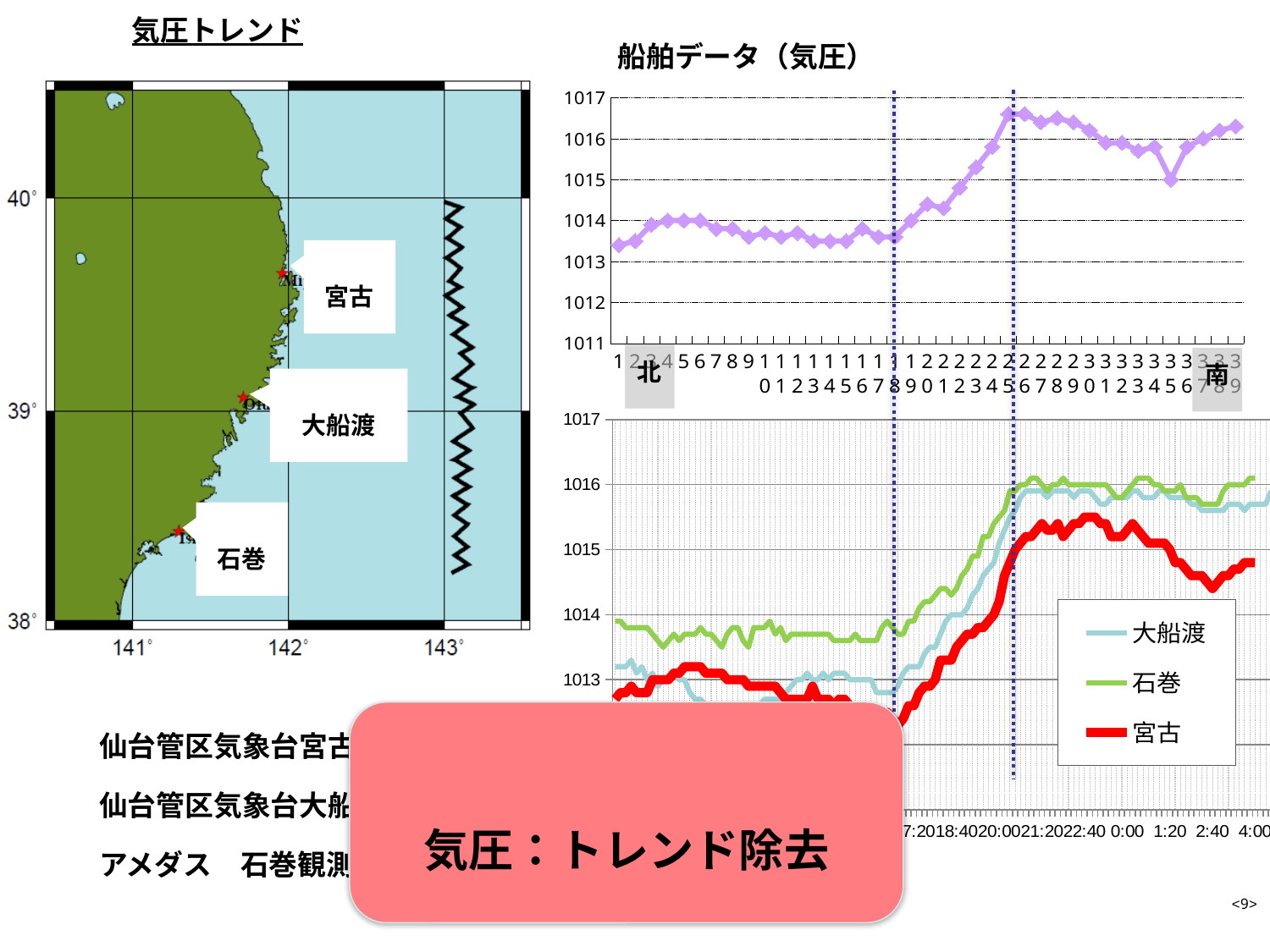
In the top chart 船舶データ（気圧）, is the highest point greater or less than 1016? greater In the bottom chart, which series is drawn in red? 宮古 In the bottom chart, at the right end of the x axis, which series is higher: 石巻 or 宮古? 石巻 What kind of chart is the top chart titled 船舶データ（気圧）? line chart In the bottom chart, is the value of 宮古 at the right end of the x axis greater or less than 1015? less In the top chart 船舶データ（気圧）, do the values overall rise or fall from left to right? rise How many series does the legend of the bottom chart list? 3 In the top chart 船舶データ（気圧）, is the value at x = 1 greater or less than 1014? less How many data points are plotted in the top chart 船舶データ（気圧）? 39 In the bottom chart, which series is lowest at the right end of the x axis? 宮古 What are the three series named in the legend of the bottom chart? 大船渡, 石巻, 宮古